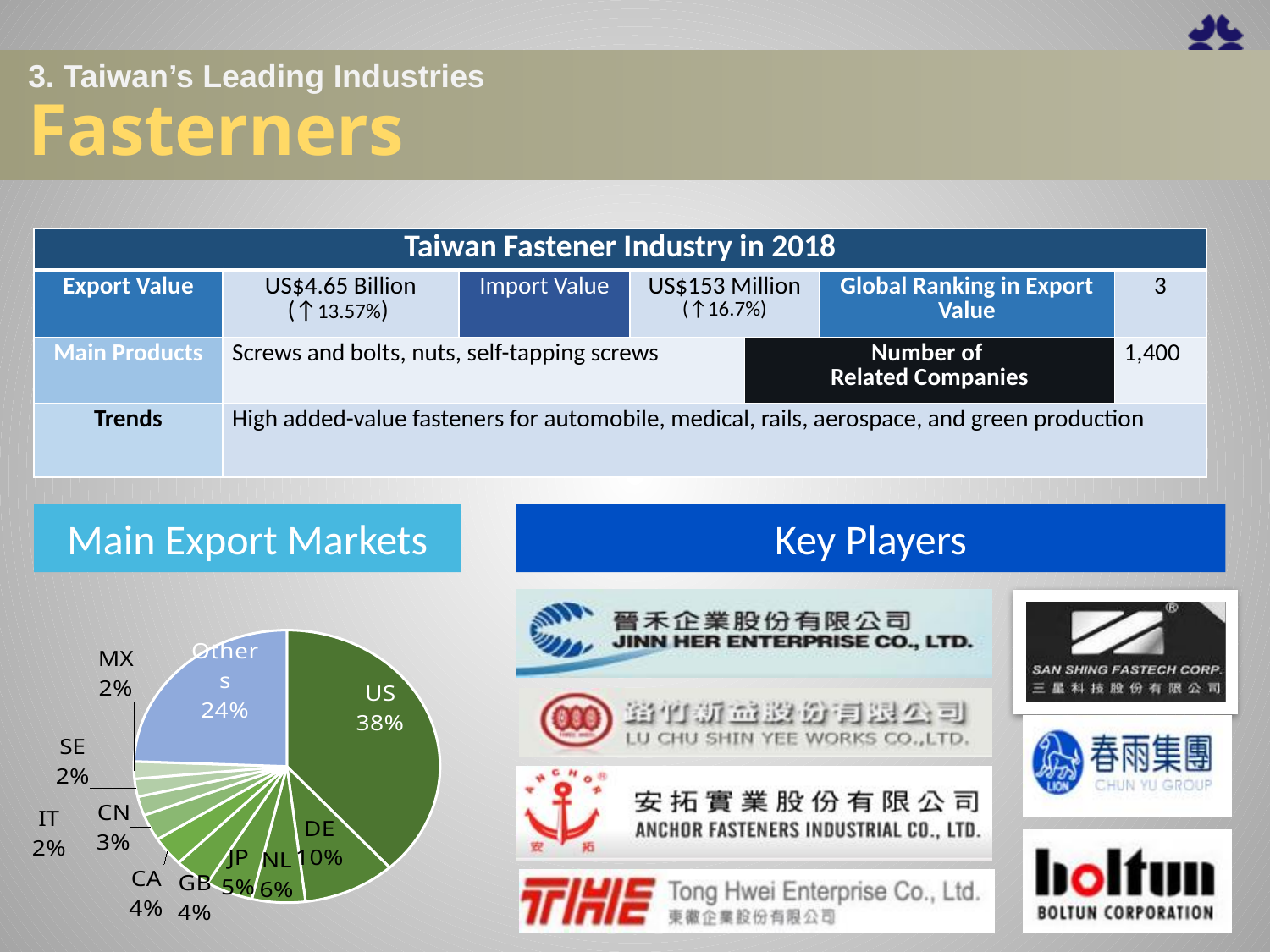
What kind of chart is shown under Main Export Markets? pie chart What is the title of the section containing the pie chart? Main Export Markets How many slices does the Main Export Markets pie chart have? 11 In the Main Export Markets pie chart, what share does CN hold? 3% In the Main Export Markets pie chart, what is the difference between the US share and the DE share? 28% In the Main Export Markets pie chart, what share does NL hold? 6% In the Main Export Markets pie chart, what share does DE hold? 10% In the Main Export Markets pie chart, what share does the US hold? 38% In the Main Export Markets pie chart, which named country has the largest share? US In the Main Export Markets pie chart, which is larger, the share for NL or the share for JP? NL In the Main Export Markets pie chart, what share is labelled Others? 24% In the Main Export Markets pie chart, what share does JP hold? 5%